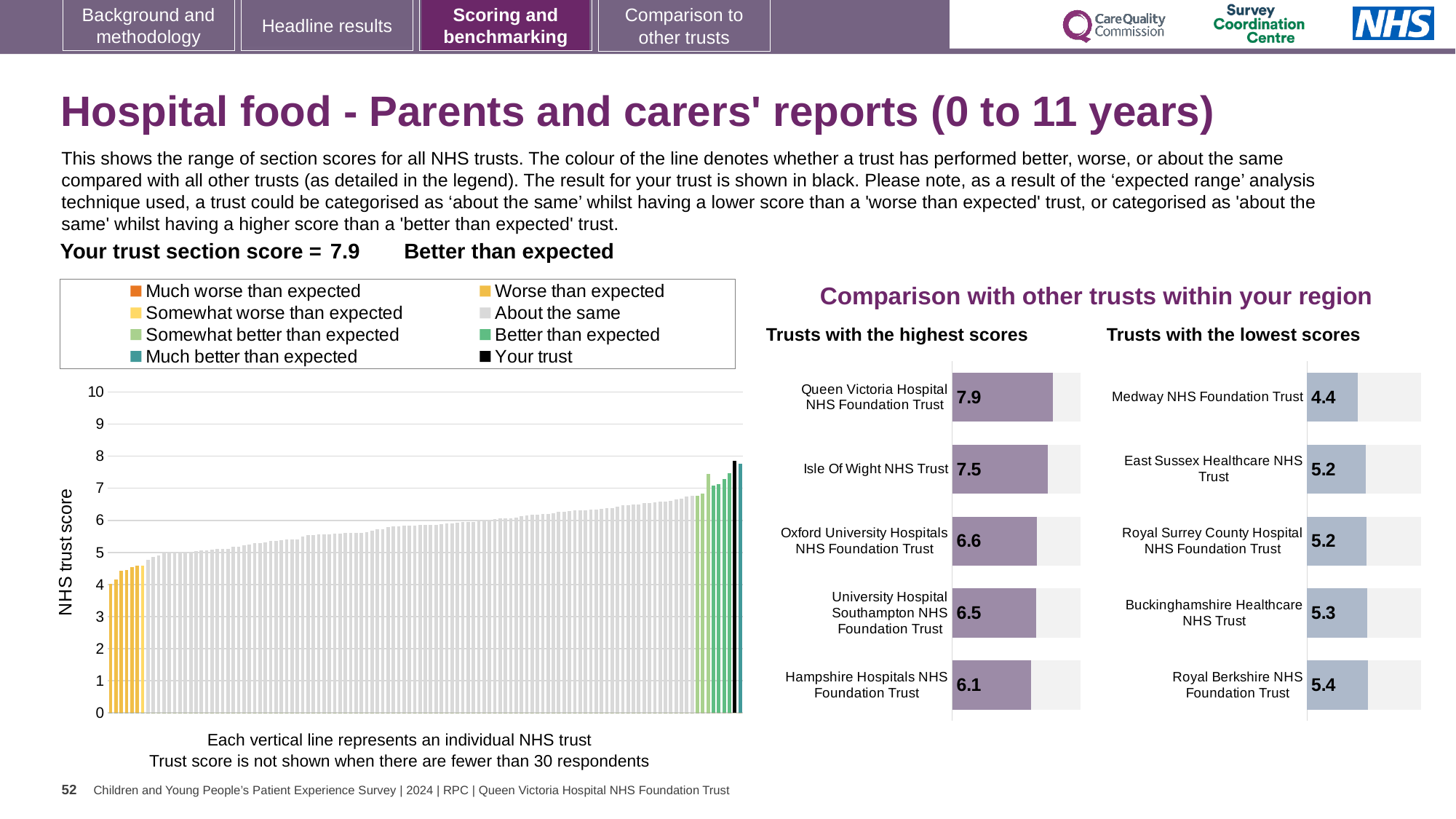
In the 'Trusts with the highest scores' chart, what is the difference between the scores of Queen Victoria Hospital NHS Foundation Trust and Oxford University Hospitals NHS Foundation Trust? 1.3 What kind of chart is the 'NHS trust score' chart on the left of the slide? Bar chart In the 'Trusts with the highest scores' chart, what is the score for Hampshire Hospitals NHS Foundation Trust? 6.1 In the 'Trusts with the lowest scores' chart, what is the score for Buckinghamshire Healthcare NHS Trust? 5.3 In the 'Trusts with the lowest scores' chart, which trust has the lowest score? Medway NHS Foundation Trust In the 'Trusts with the highest scores' chart, which trust has the highest score? Queen Victoria Hospital NHS Foundation Trust In the 'Trusts with the lowest scores' chart, what is the difference between the scores of Royal Berkshire NHS Foundation Trust and Medway NHS Foundation Trust? 1.0 In the 'NHS trust score' chart on the left, do the bars rise or fall from left to right? Rise How many trusts are shown in the 'Trusts with the lowest scores' chart? 5 In the 'Trusts with the highest scores' chart, what is the score for Isle Of Wight NHS Trust? 7.5 In the 'Trusts with the lowest scores' chart, what is the score for Medway NHS Foundation Trust? 4.4 In the 'Trusts with the highest scores' chart, which has the larger score: University Hospital Southampton NHS Foundation Trust or Hampshire Hospitals NHS Foundation Trust? University Hospital Southampton NHS Foundation Trust